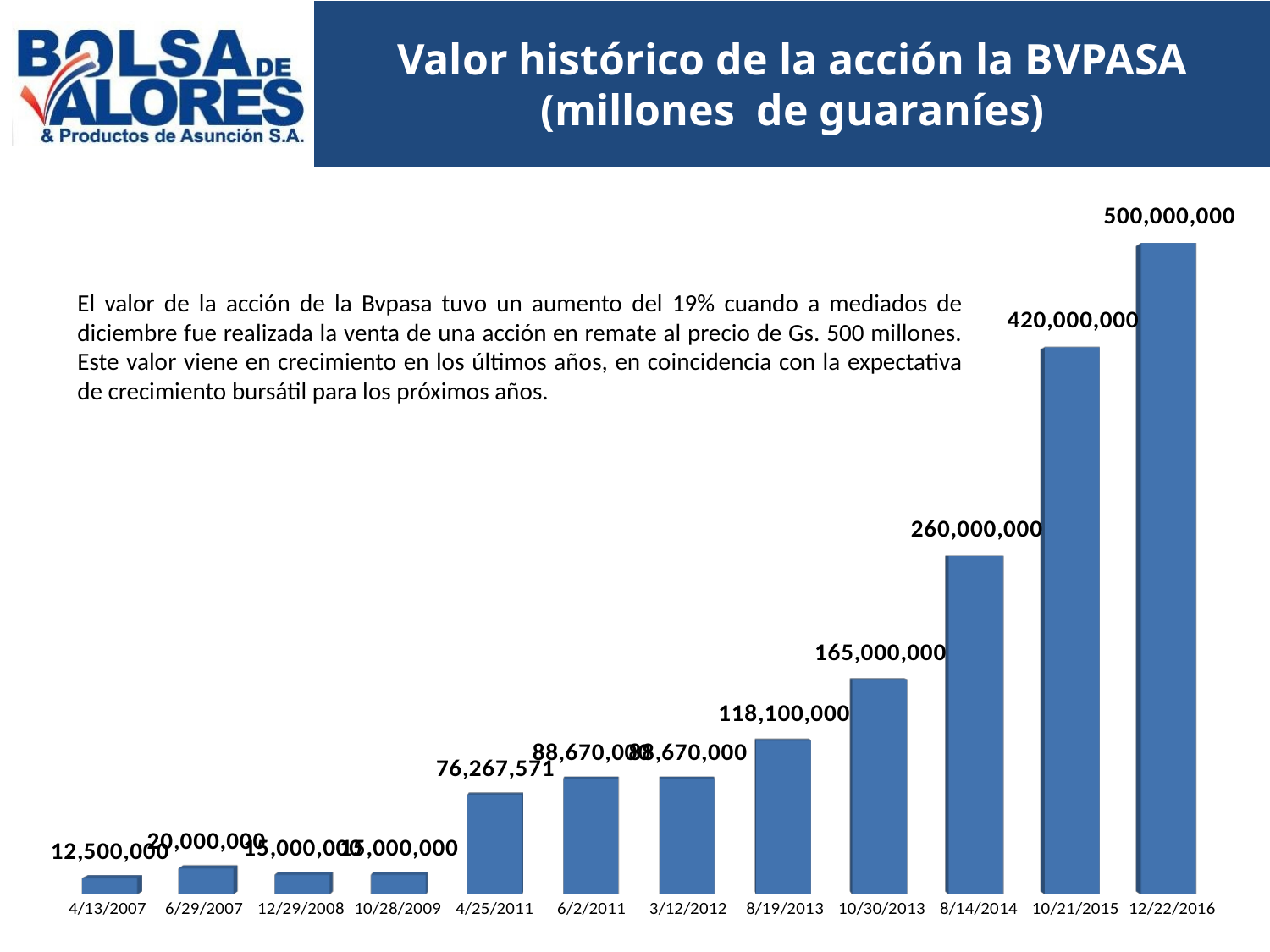
What type of chart is shown on the slide? Bar chart What is the value for 10/21/2015? 420,000,000 What is the value for 12/22/2016? 500,000,000 What is the difference between the values for 12/22/2016 and 10/21/2015? 80,000,000 Which date has the lowest value? 4/13/2007 How many bars are shown in the chart? 12 What is the value for 8/14/2014? 260,000,000 Which is larger, the value for 10/30/2013 or the value for 8/19/2013? 10/30/2013 Do the values generally rise or fall from left to right along the x axis? Rise What is the value for 4/25/2011? 76,267,571 Which date has the highest value? 12/22/2016 What is the value for 8/19/2013? 118,100,000